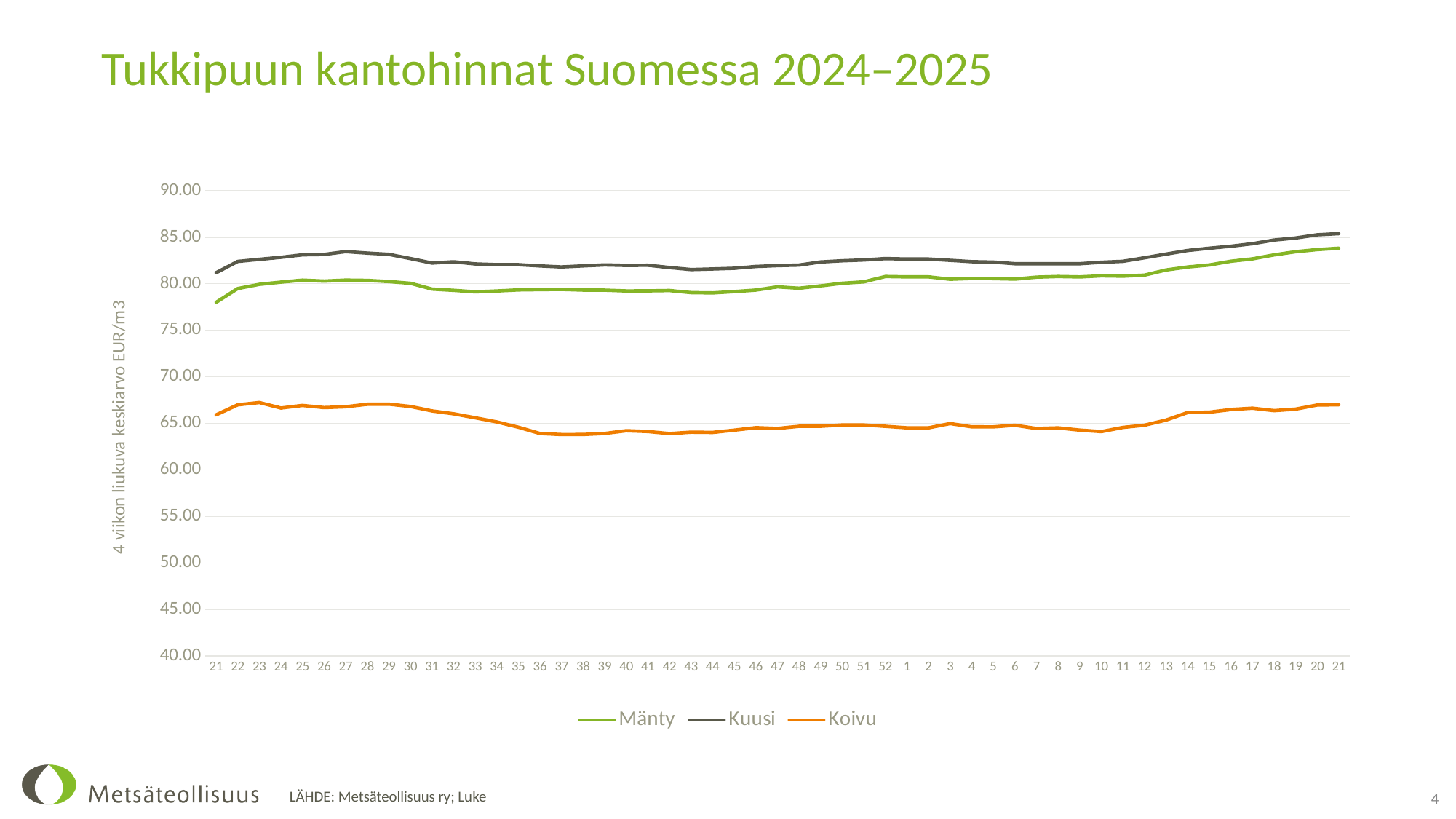
What kind of chart is shown on the slide? line chart Is the value for Mänty at the last week 21 greater or less than 80? greater Is the value for Koivu at week 36 greater or less than 65? less At week 40, which is larger, the value for Kuusi or the value for Mänty? Kuusi Which series are listed in the legend? Mänty, Kuusi, Koivu Is the value for Mänty at the first week 21 greater or less than 80? less Which series has the lowest values throughout the chart? Koivu How many series does the legend list? 3 Does the Koivu line rise or fall between week 29 and week 36? fall Which series has the highest values throughout the chart? Kuusi What is the title of the chart? Tukkipuun kantohinnat Suomessa 2024–2025